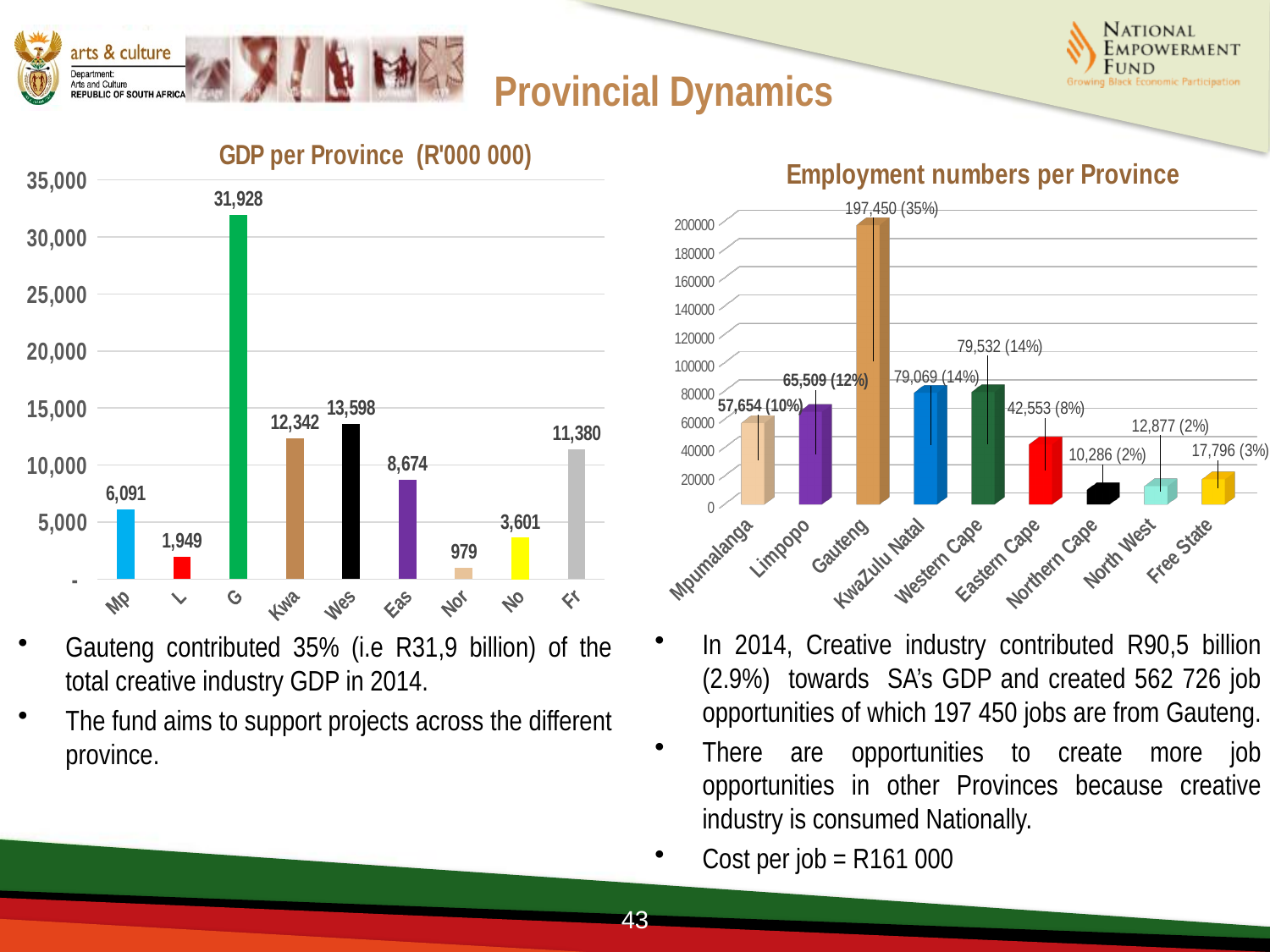
How many bars are shown in the GDP per Province chart? 9 In the Employment numbers per Province chart, is the value for Free State greater or less than 20000? less In the GDP per Province chart, which category has the lowest value? Nor In the Employment numbers per Province chart, what is the value for Gauteng? 197,450 (35%) In the GDP per Province chart, which is larger, the value for Fr or the value for Mp? Fr In the Employment numbers per Province chart, which province has the lowest employment number? Northern Cape In the GDP per Province chart, what is the value for the bar labelled G? 31,928 In the GDP per Province chart, what is the value for the bar labelled Kwa? 12,342 In the GDP per Province chart, what is the difference between the values for Wes and Eas? 4,924 In the Employment numbers per Province chart, what is the difference between the employment numbers for Limpopo and Mpumalanga? 7,855 What type of chart is the Employment numbers per Province chart? Bar chart In the Employment numbers per Province chart, what is the value for Eastern Cape? 42,553 (8%)